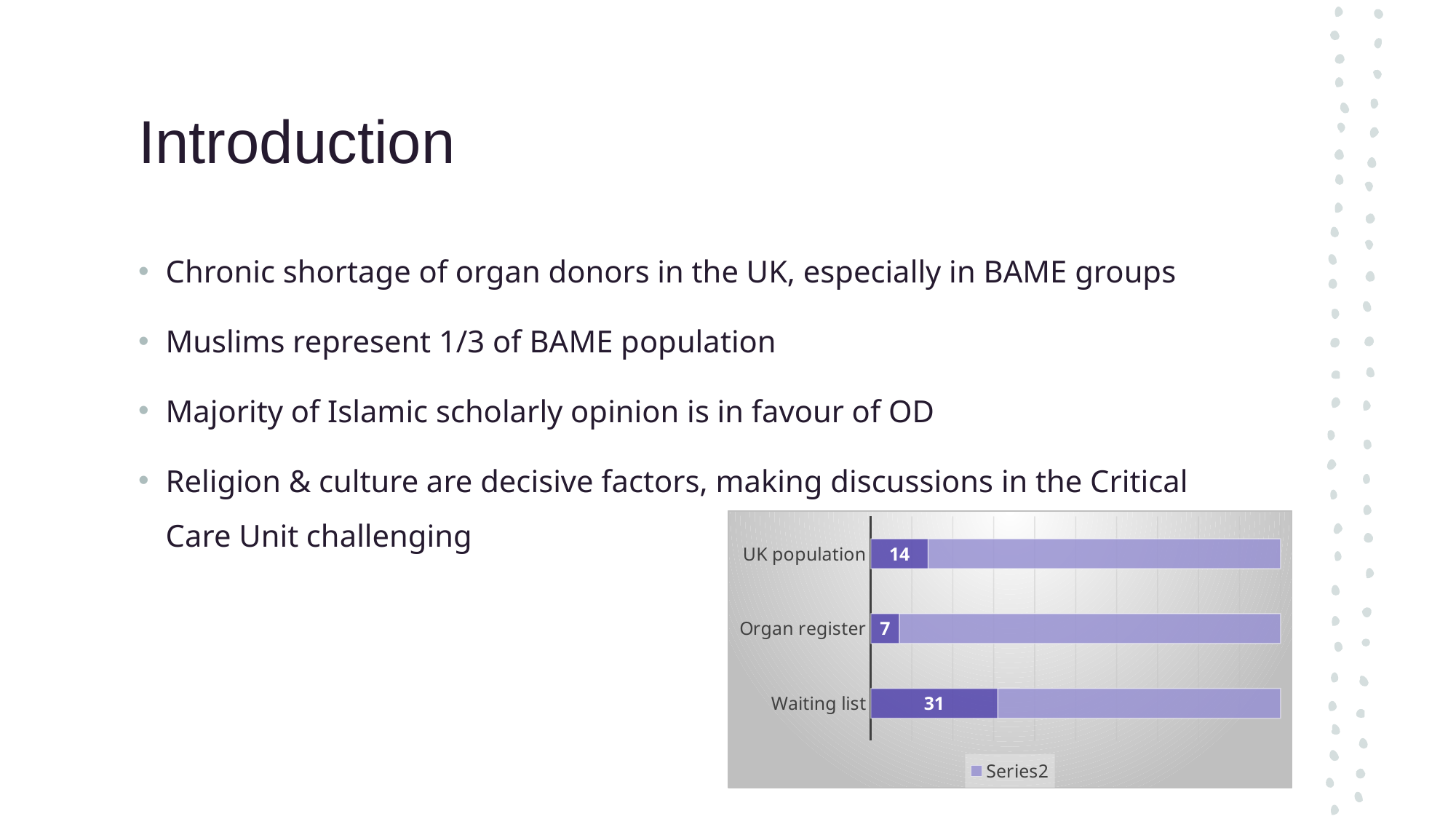
Which category has the lowest labelled value? Organ register What is the value shown for Waiting list? 31 Which is larger, the value for UK population or the value for Organ register? UK population What is the difference between the values for Waiting list and UK population? 17 What is the value shown for UK population? 14 What is the difference between the values for UK population and Organ register? 7 What is the name of the series shown in the chart legend? Series2 What is the value shown for Organ register? 7 How many series does the chart legend list? 1 Which category has the highest labelled value? Waiting list What kind of chart is shown on the slide? Bar chart How many categories are shown in the chart? 3